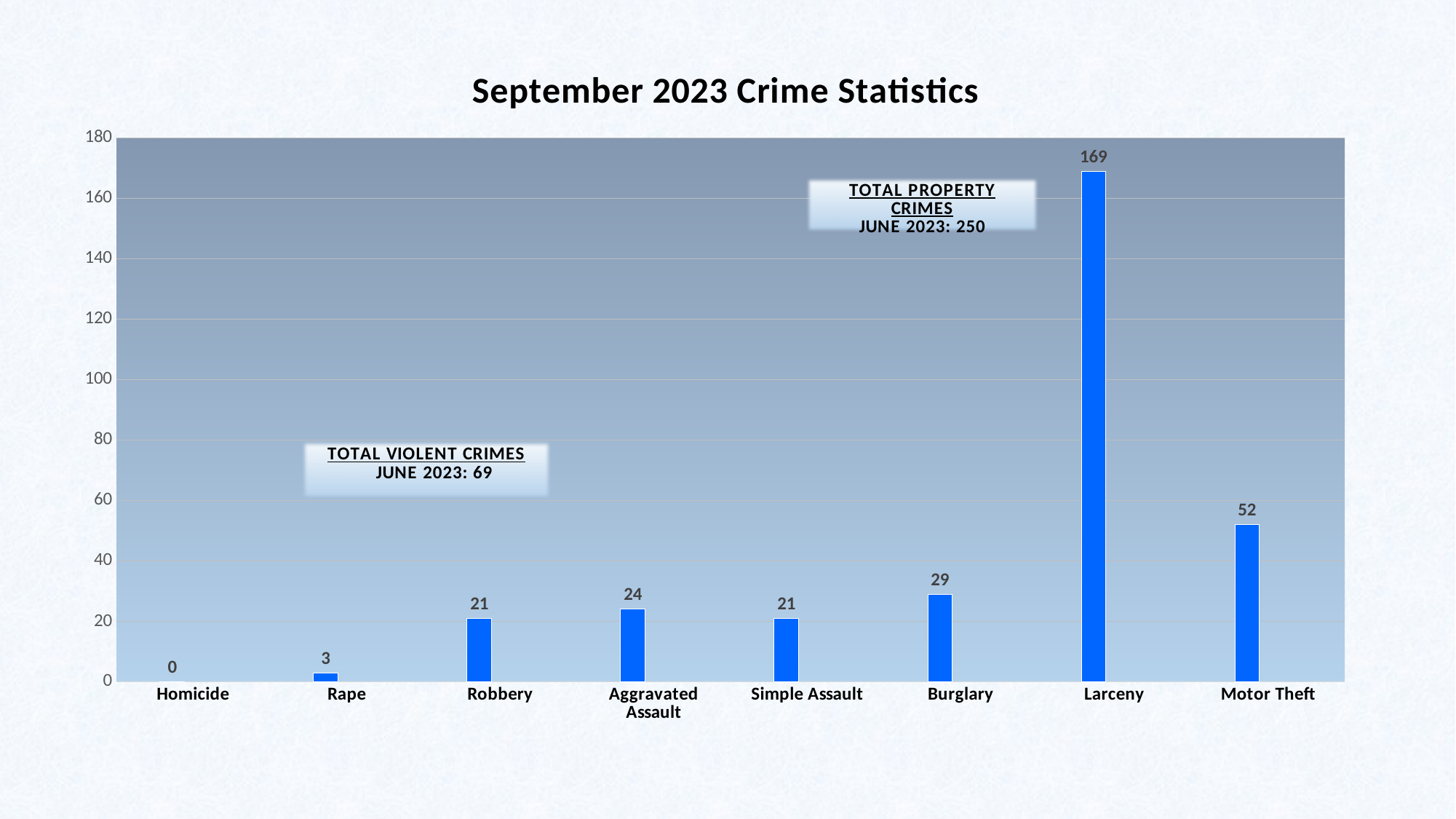
Which category has the highest value? Larceny What is the value for Larceny? 169 What is the title of the chart? September 2023 Crime Statistics What is the value for Burglary? 29 Which is larger, the value for Aggravated Assault or the value for Robbery? Aggravated Assault What is the difference between the values for Larceny and Motor Theft? 117 What is the value for Rape? 3 Is the value for Larceny greater or less than 160? greater How many categories are shown on the x axis? 8 What kind of chart is shown on the slide? bar chart What is the value for Motor Theft? 52 Which category has the lowest value? Homicide